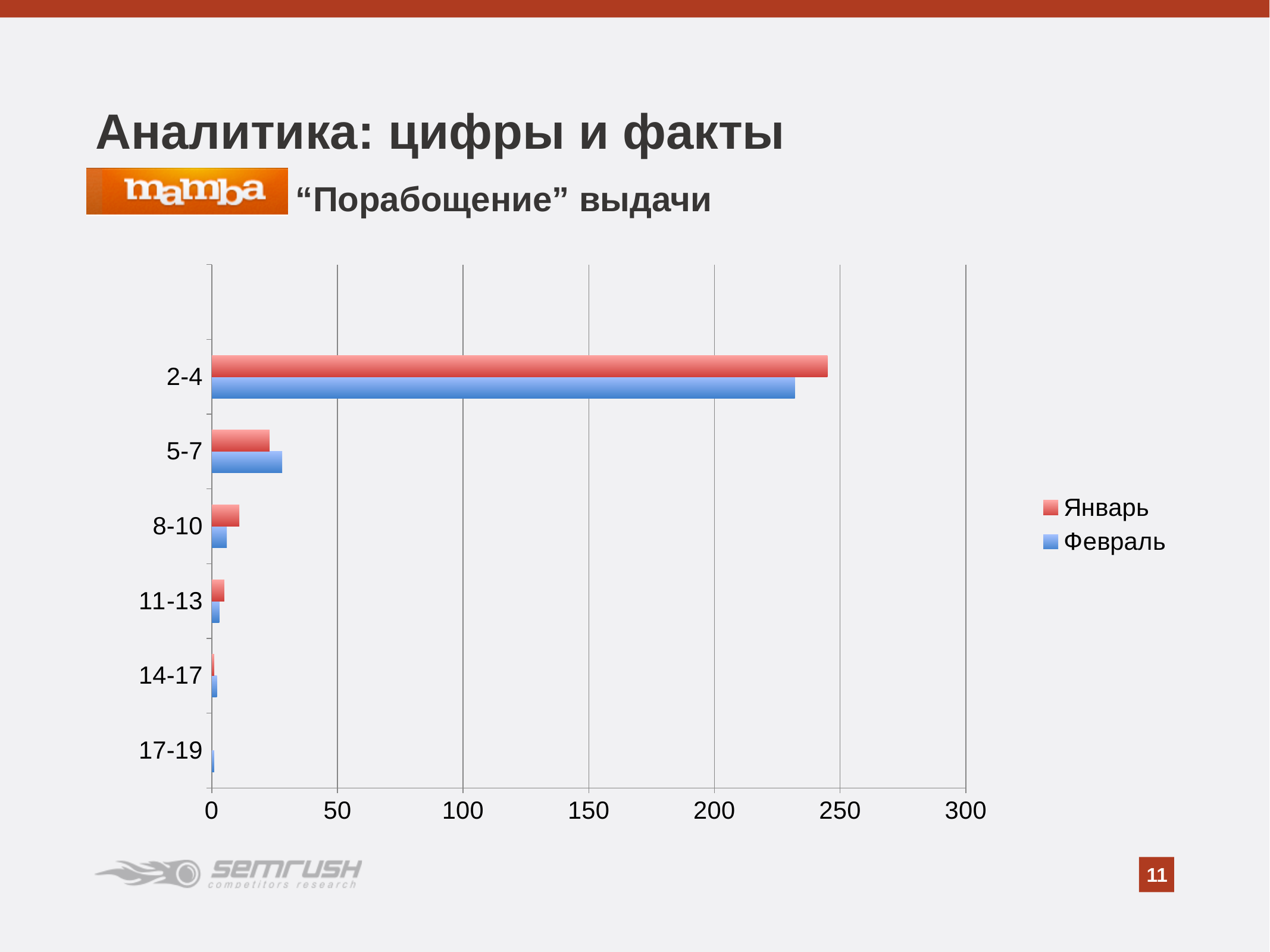
Which category has the highest value for Январь? 2-4 How many series does the chart legend list? 2 Do the Январь values rise or fall going from category 2-4 down to category 17-19? fall What colour represents the Февраль series in the chart? blue Is the value for Январь in category 2-4 greater or less than 200? greater How many categories are shown on the vertical axis of the chart? 6 Is the value for Февраль in category 2-4 greater or less than 200? greater Which category has the highest value for Февраль? 2-4 Is the value for Февраль in category 5-7 greater or less than 50? less What kind of chart is shown on the slide? bar chart In category 2-4, which series has the larger value, Январь or Февраль? Январь In category 5-7, which series has the larger value, Январь or Февраль? Февраль